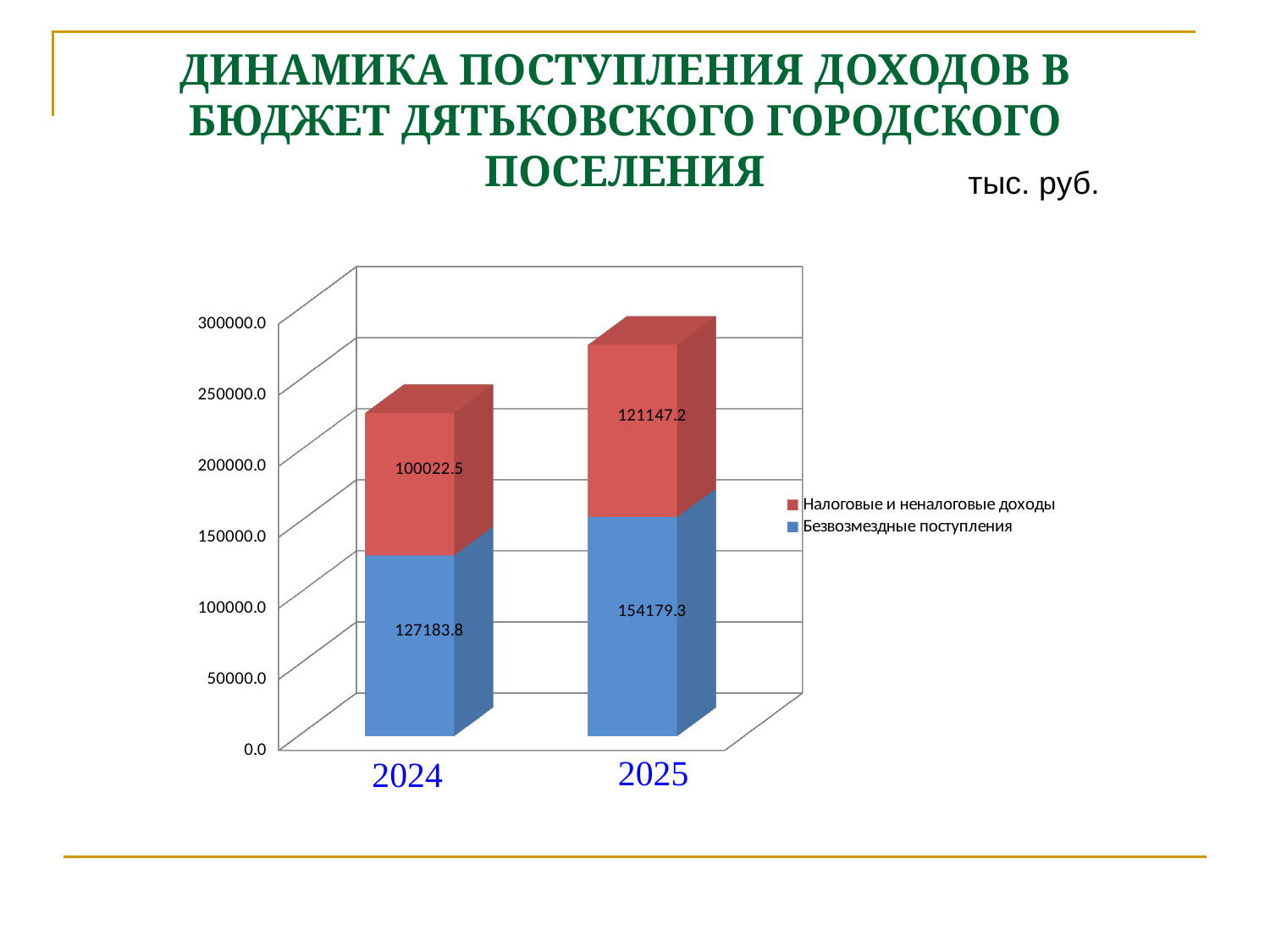
What is the total of the stacked bar for 2024? 227206.3 How many series does the legend list? 2 How many years are shown on the x axis? 2 Which year has the larger value for Налоговые и неналоговые доходы, 2024 or 2025? 2025 By how much does Безвозмездные поступления in 2025 exceed the 2024 value? 26995.5 What kind of chart is shown on the slide? Stacked bar chart What is the value of Безвозмездные поступления for 2025? 154179.3 What is the value of Налоговые и неналоговые доходы for 2025? 121147.2 Which series is shown in red in the legend? Налоговые и неналоговые доходы What is the value of Безвозмездные поступления for 2024? 127183.8 What is the value of Налоговые и неналоговые доходы for 2024? 100022.5 What is the total of the stacked bar for 2025? 275326.5